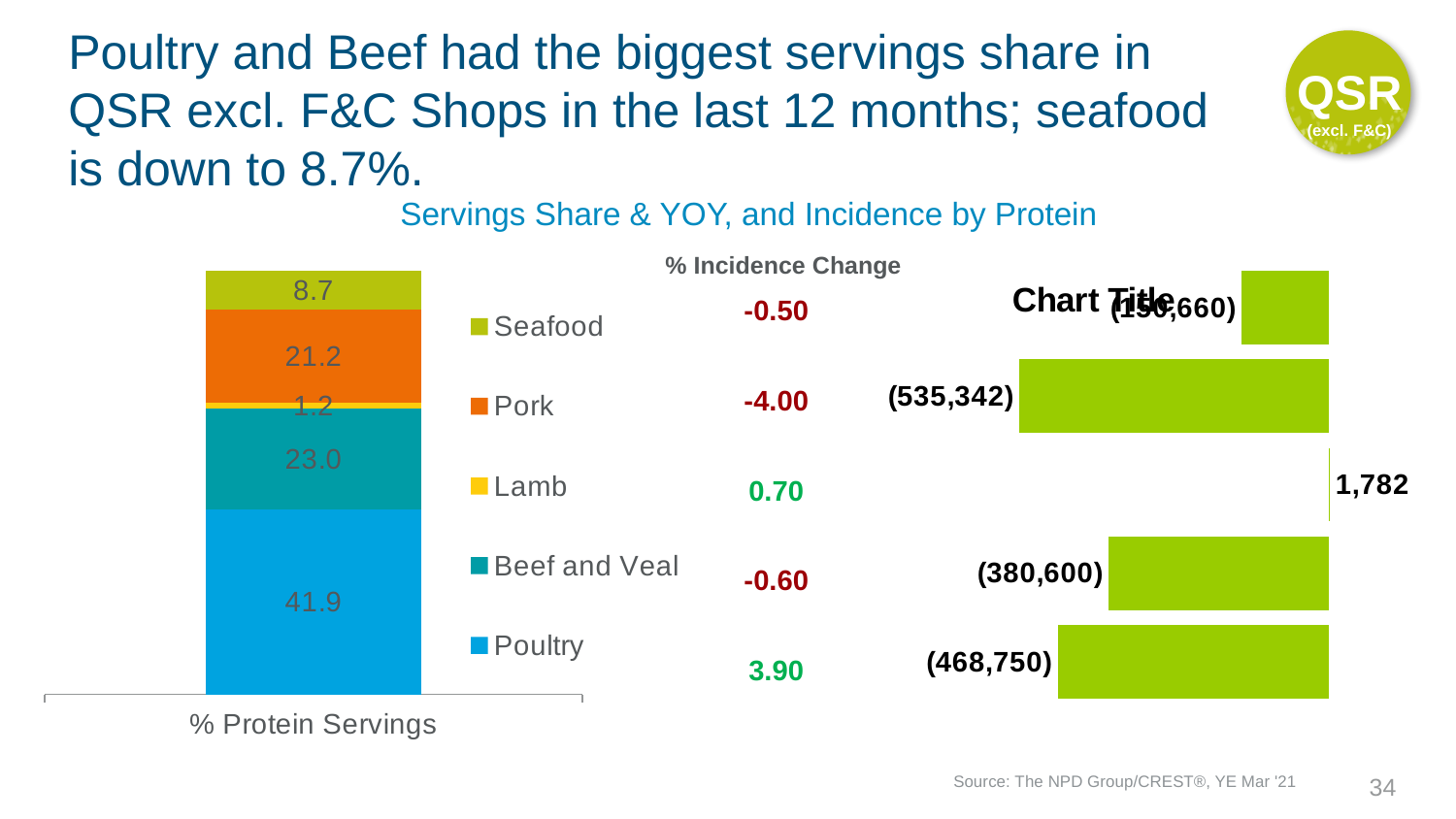
What type of chart is the % Protein Servings chart? Stacked bar chart In the % Protein Servings stacked bar chart, what is the value for Pork? 21.2 In the % Protein Servings stacked bar chart, what is the difference between the Poultry and Beef and Veal values? 18.9 In the right-hand bar chart titled Chart Title, what is the value of the middle bar (third from top)? 1,782 In the % Protein Servings stacked bar chart, which is larger, Pork or Beef and Veal? Beef and Veal What is the % Incidence Change value shown for Pork? -4.00 How many series does the legend of the % Protein Servings chart list? 5 In the % Protein Servings stacked bar chart, what is the value for Poultry? 41.9 What is the % Incidence Change value shown for Poultry? 3.90 In the % Protein Servings stacked bar chart, which protein has the smallest share? Lamb In the % Protein Servings stacked bar chart, which protein has the largest share? Poultry In the % Protein Servings stacked bar chart, what is the value for Seafood? 8.7